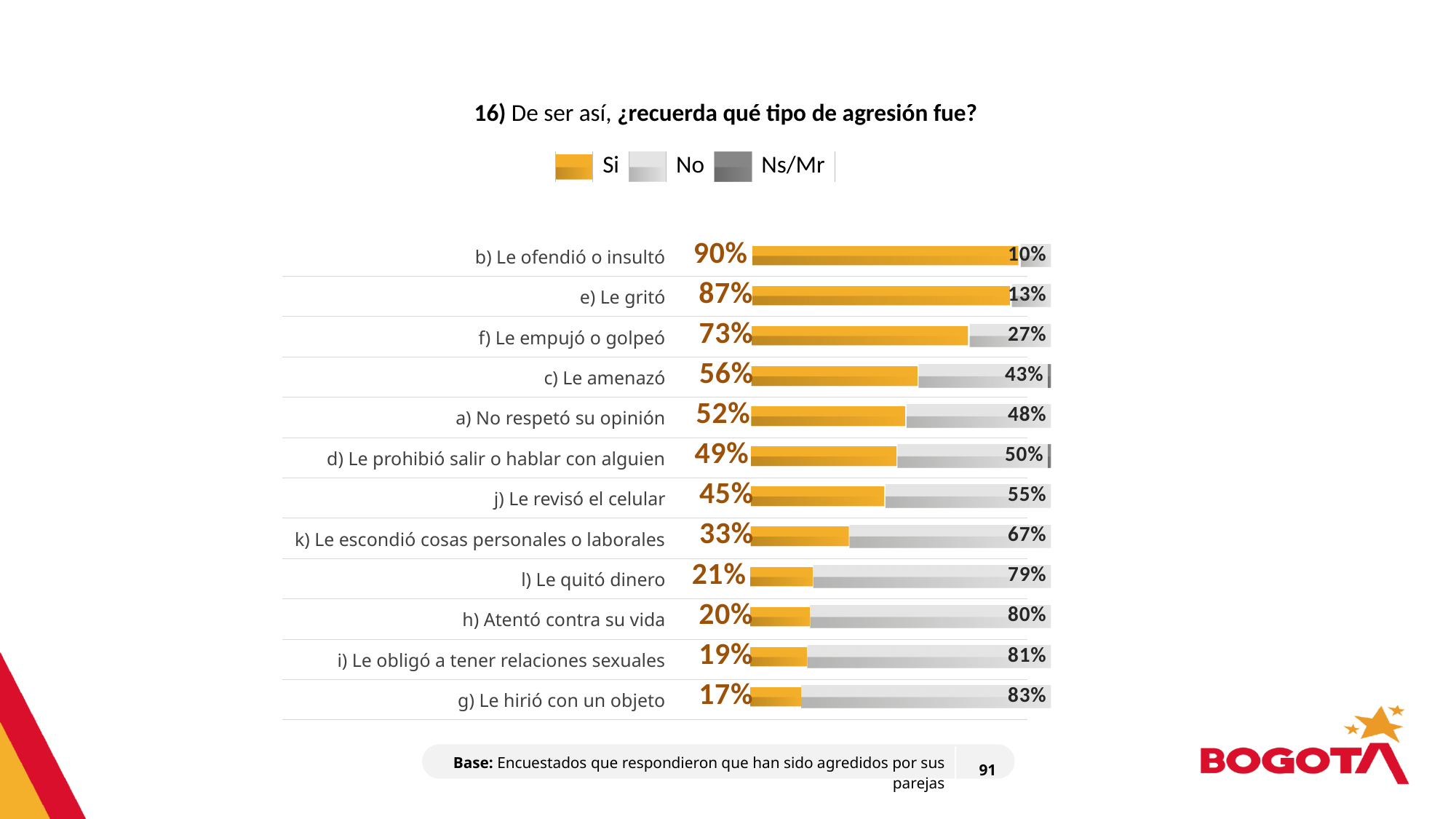
How many categories (types of aggression) are shown in the chart? 12 What is the base (number of respondents) shown at the bottom of the chart? 91 What kind of chart is shown on the slide? Bar chart Which has a larger "Si" value: "k) Le escondió cosas personales o laborales" or "l) Le quitó dinero"? k) Le escondió cosas personales o laborales What is the "No" value for "h) Atentó contra su vida"? 80% What percentage answered "Si" for "b) Le ofendió o insultó"? 90% How many series does the legend list? 3 Which category has the lowest "Si" percentage? g) Le hirió con un objeto What is the "Si" value for "j) Le revisó el celular"? 45% What is the difference between the "Si" values for "e) Le gritó" and "c) Le amenazó"? 31% Which category has the highest "Si" percentage? b) Le ofendió o insultó What percentage answered "No" for "f) Le empujó o golpeó"? 27%